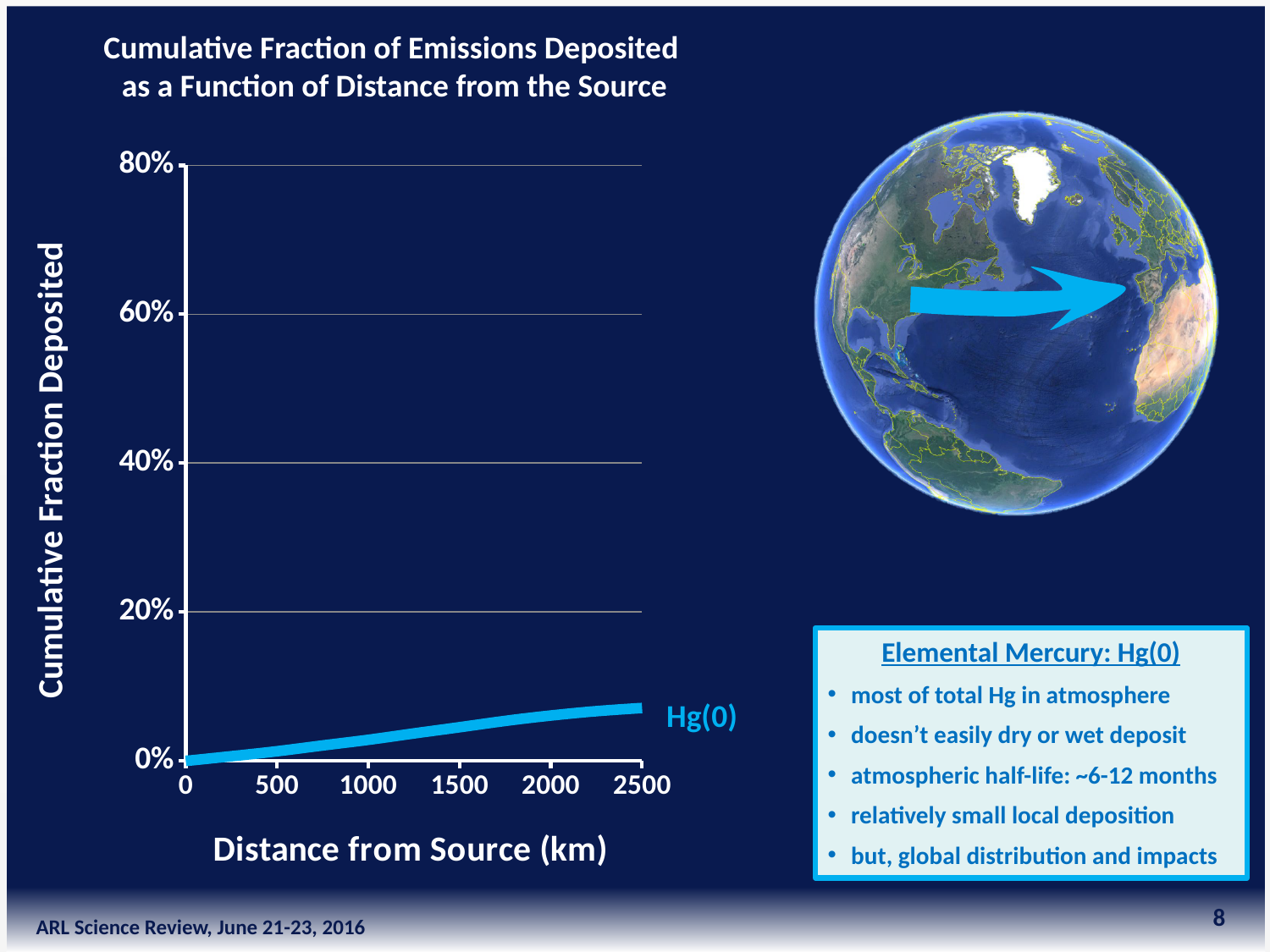
Is the value for Hg(0) at 1000 km greater or less than 20%? less What is the label of the x axis? Distance from Source (km) Is the value for Hg(0) at 2500 km greater or less than 20%? less Is the value for Hg(0) at 2500 km greater or less than 40%? less What is the highest value shown on the y axis? 80% At which distance is the Hg(0) value highest, 0 km or 2500 km? 2500 km What is the title of the chart? Cumulative Fraction of Emissions Deposited as a Function of Distance from the Source What kind of chart is shown on the slide? line chart Does the Hg(0) line rise or fall as distance from the source increases? rise How many series are plotted on the chart? 1